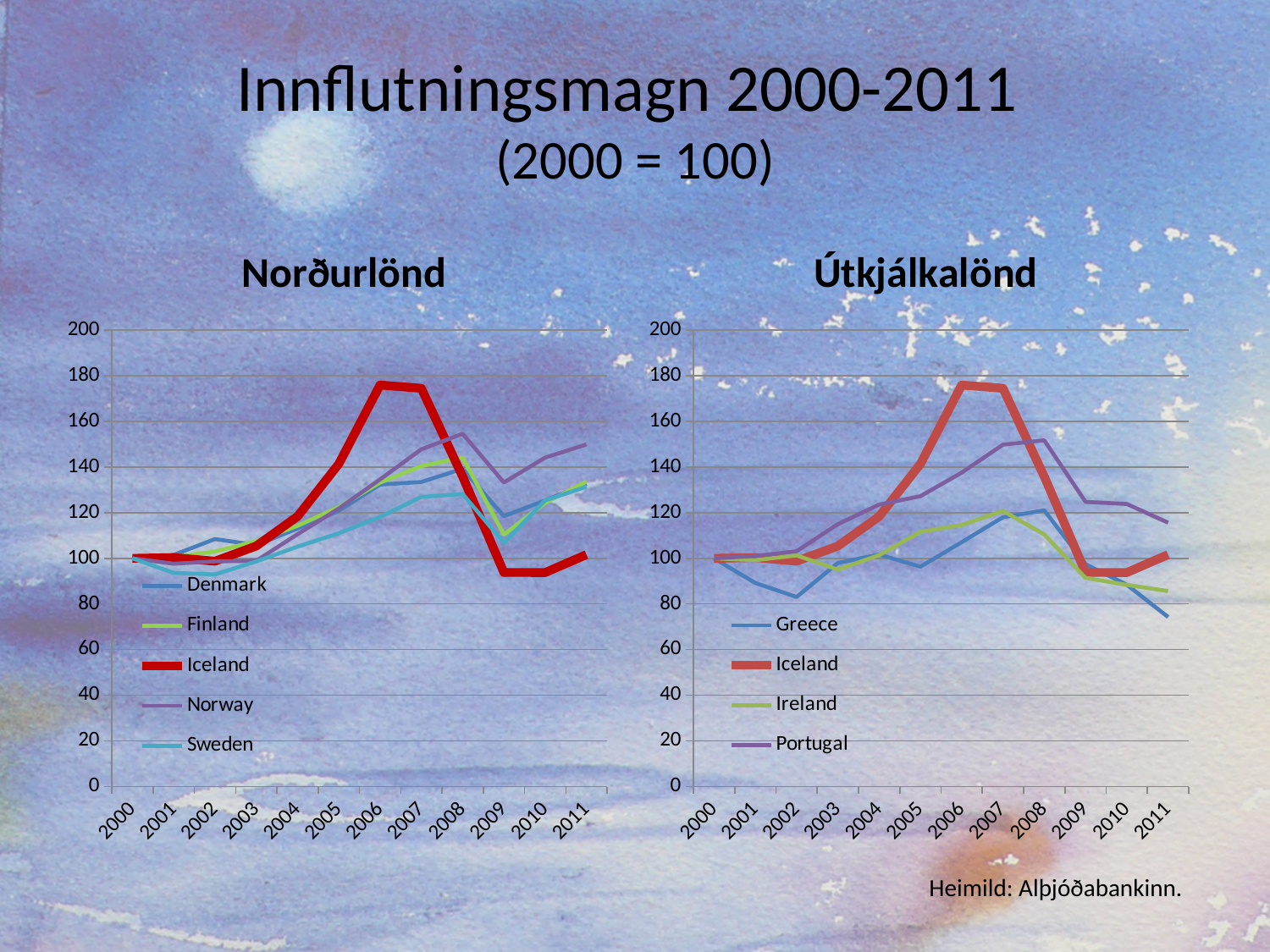
In the Norðurlönd chart, is the value for Iceland in 2009 greater or less than 100? less How many years are shown on the x axis of the Útkjálkalönd chart? 12 What is the title of the chart on the right side of the slide? Útkjálkalönd In the Norðurlönd chart, is the value for Iceland in 2006 greater or less than 160? greater In the Útkjálkalönd chart, which series has the lowest value in 2011? Greece How many series does the legend of the Útkjálkalönd chart list? 4 What kind of chart is the Norðurlönd chart? line chart In the Útkjálkalönd chart, is the value for Greece in 2011 greater or less than 80? less How many series does the legend of the Norðurlönd chart list? 5 In the Norðurlönd chart, which is larger in 2007, Iceland or Denmark? Iceland In the Norðurlönd chart, which series has the highest value in 2006? Iceland In the Útkjálkalönd chart, does the Iceland line rise or fall from 2007 to 2009? fall